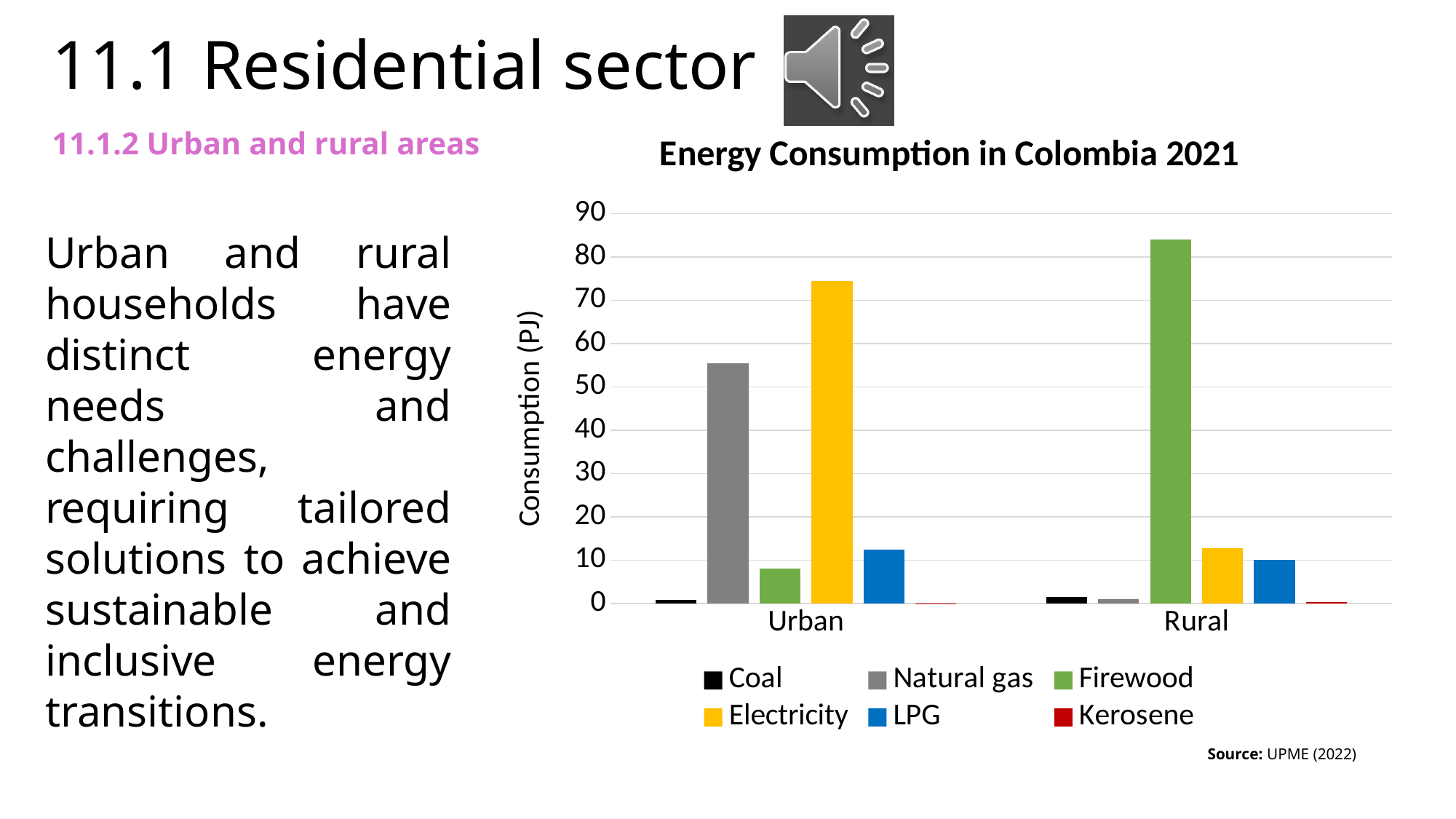
Is the value for Electricity in the Urban category greater or less than 70? greater Which category has the larger Natural gas consumption, Urban or Rural? Urban Is the value for Firewood in the Rural category greater or less than 80? greater Which category has the larger Electricity consumption, Urban or Rural? Urban What is the title of the chart? Energy Consumption in Colombia 2021 Which energy source has the highest consumption in the Urban category? Electricity What kind of chart is shown on the slide? bar chart How many series does the legend of the chart list? 6 Is the value for Firewood in the Urban category greater or less than 10? less How many categories are shown on the x axis of the chart? 2 Which energy source has the highest consumption in the Rural category? Firewood